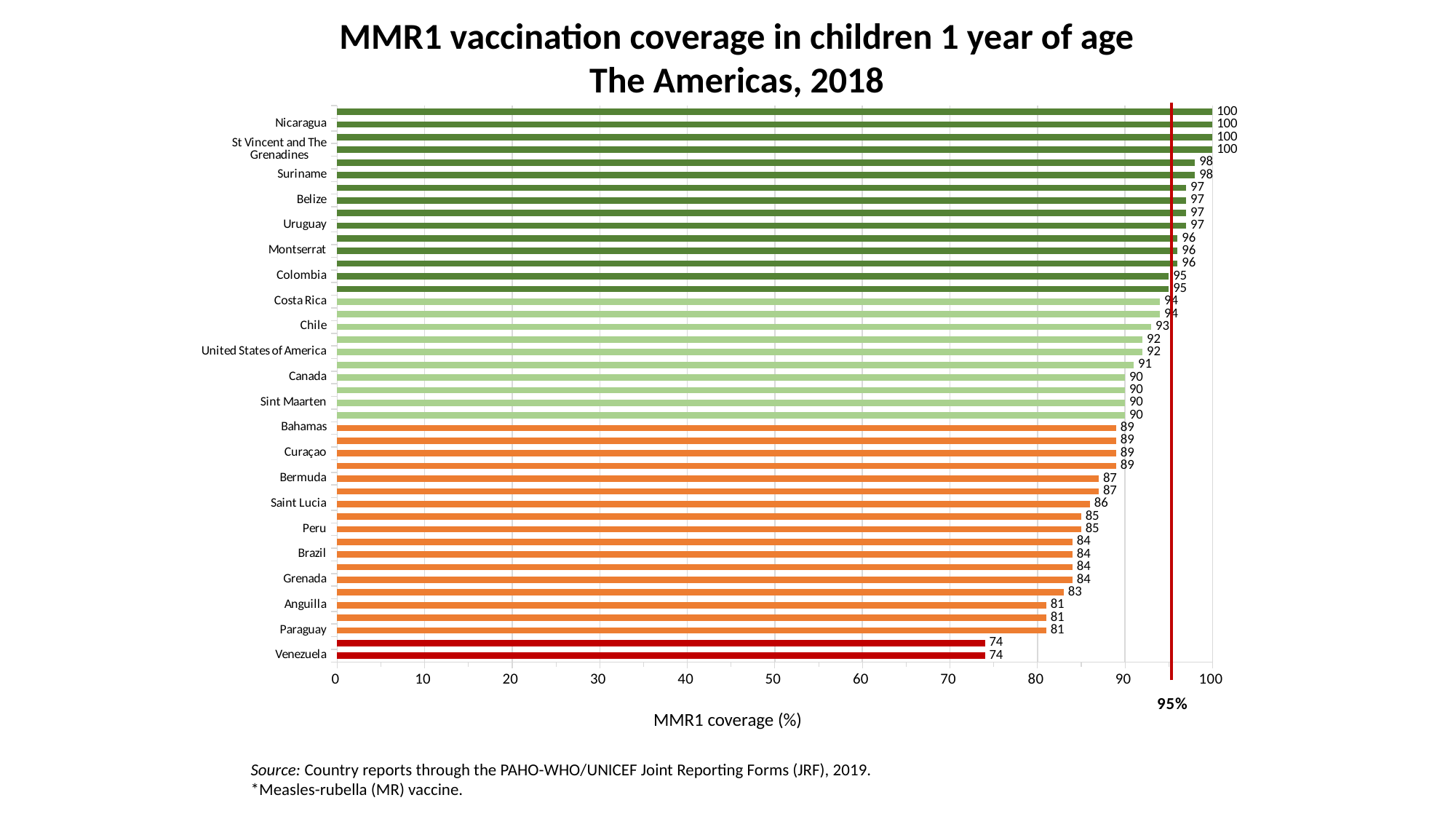
What is the MMR1 coverage value shown for Chile? 93 Which has a higher MMR1 coverage value, Chile or Peru? Chile What is the MMR1 coverage value shown for Nicaragua? 100 What value does the vertical red reference line on the chart mark? 95% What kind of chart is shown on the slide? bar chart What is the difference between the MMR1 coverage values for Nicaragua and Venezuela? 26 What is the title of the x axis of the chart? MMR1 coverage (%) What is the MMR1 coverage value shown for Colombia? 95 What is the MMR1 coverage value shown for the United States of America? 92 Is the MMR1 coverage value for Bermuda greater or less than 90? less Which has a higher MMR1 coverage value, Paraguay or Canada? Canada What is the MMR1 coverage value shown for Venezuela? 74